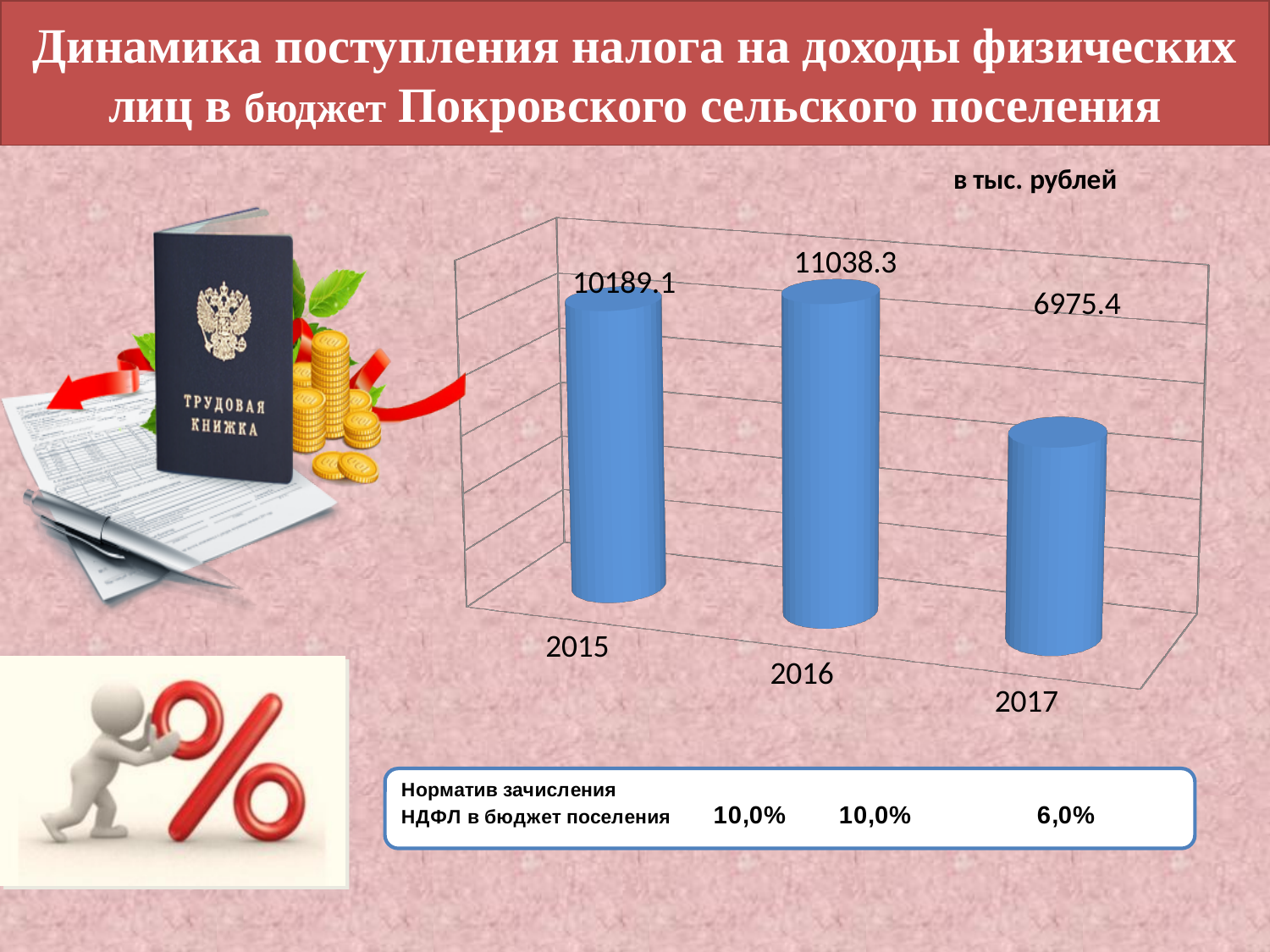
In what units are the chart values given, according to the label above the chart? в тыс. рублей What is the difference between the values for 2016 and 2017? 4062.9 Which is larger, the value for 2015 or the value for 2017? 2015 What is the value for 2015? 10189.1 Which year has the lowest value? 2017 Does the value rise or fall from 2016 to 2017? fall Which year has the highest value? 2016 What is the value for 2016? 11038.3 What kind of chart is shown on the slide? bar chart What is the value for 2017? 6975.4 What is the difference between the values for 2016 and 2015? 849.2 How many years are shown on the chart? 3